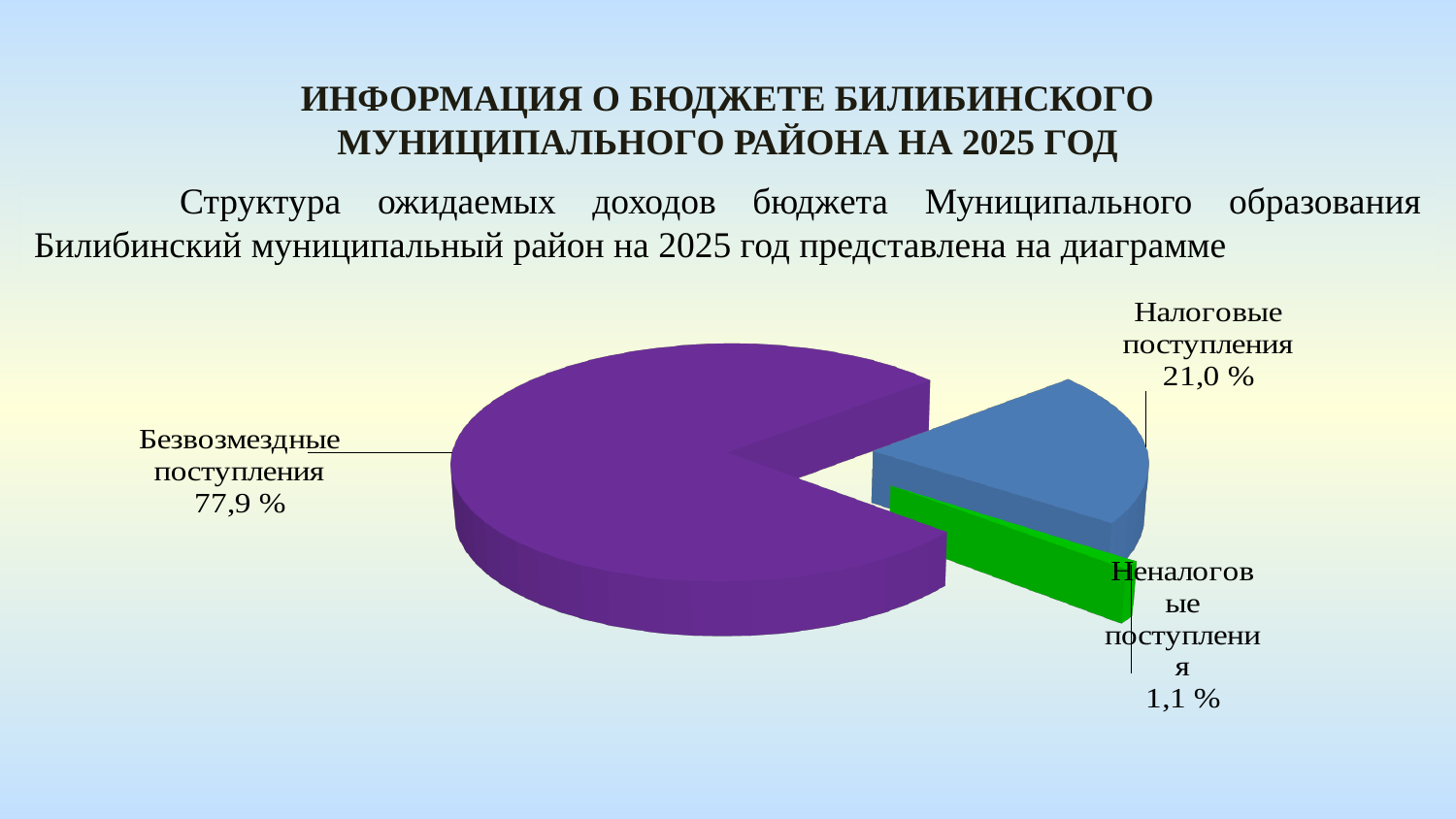
Which category has the smallest share of the pie? Неналоговые поступления What share of expected budget revenues is shown for Безвозмездные поступления? 77,9 % Which category has the largest share of the pie? Безвозмездные поступления What share of expected budget revenues is shown for Налоговые поступления? 21,0 % By how many percentage points does the share of Налоговые поступления exceed that of Неналоговые поступления? 19,9 Which is larger: the share of Налоговые поступления or the share of Неналоговые поступления? Налоговые поступления What kind of chart is shown on the slide? Pie chart By how many percentage points does the share of Безвозмездные поступления exceed that of Налоговые поступления? 56,9 What colour is the slice for Безвозмездные поступления? Purple What share of expected budget revenues is shown for Неналоговые поступления? 1,1 % How many categories are shown in the pie chart? 3 What colour is the slice for Неналоговые поступления? Green